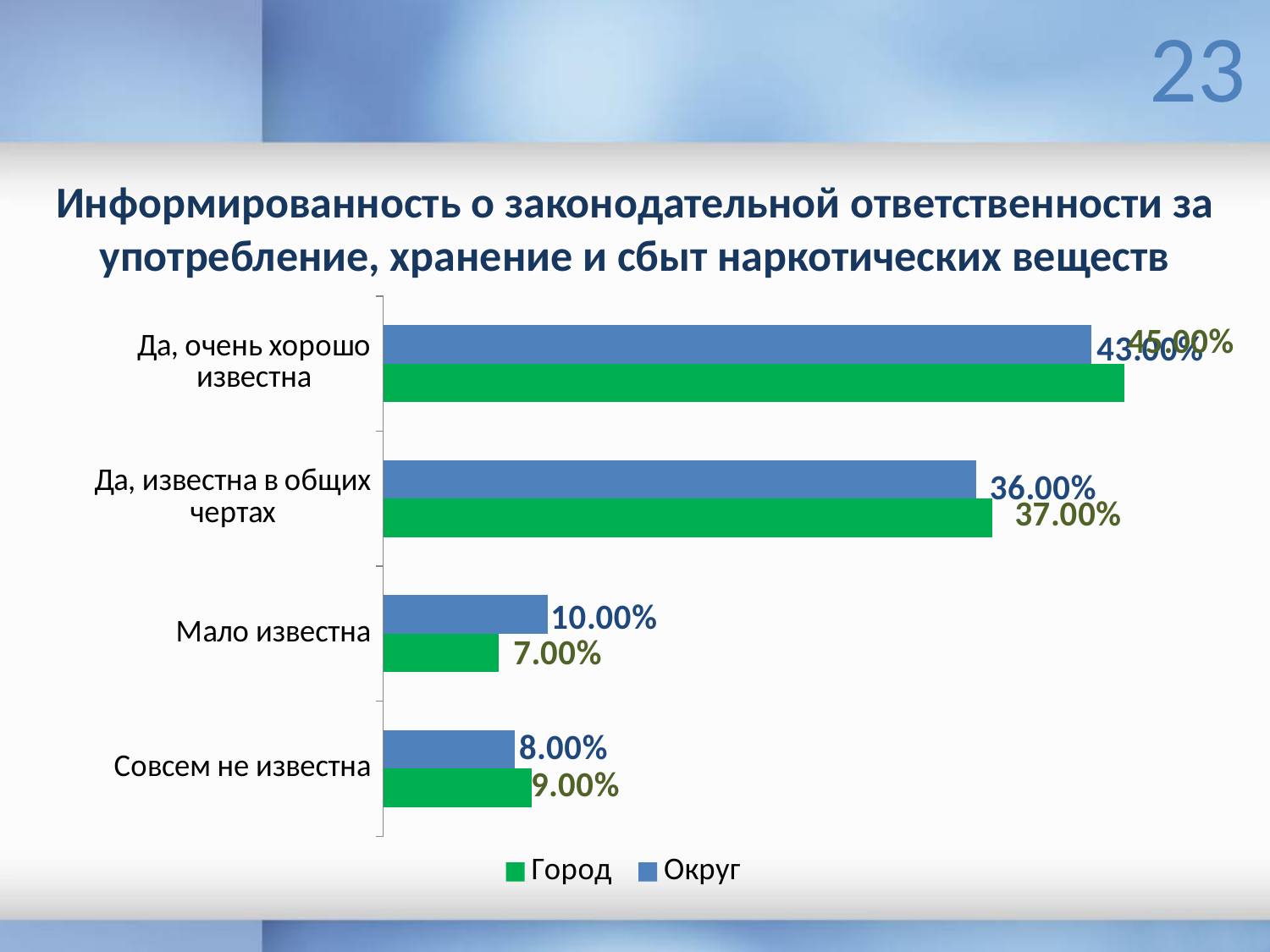
Which category has the lowest value for the Округ series? Совсем не известна What is the value for Округ in the category "Мало известна"? 10.00% How many categories are shown on the chart? 4 What is the difference between the Округ and Город values in the category "Мало известна"? 3.00% What is the value for Город in the category "Да, известна в общих чертах"? 37.00% Which category has the highest value for the Город series? Да, очень хорошо известна What is the value for Округ in the category "Совсем не известна"? 8.00% How many series does the legend list? 2 What is the value for Город in the category "Мало известна"? 7.00% What is the value for Округ in the category "Да, известна в общих чертах"? 36.00% What kind of chart is shown on the slide? bar chart In the category "Совсем не известна", which series has the larger value, Город or Округ? Город